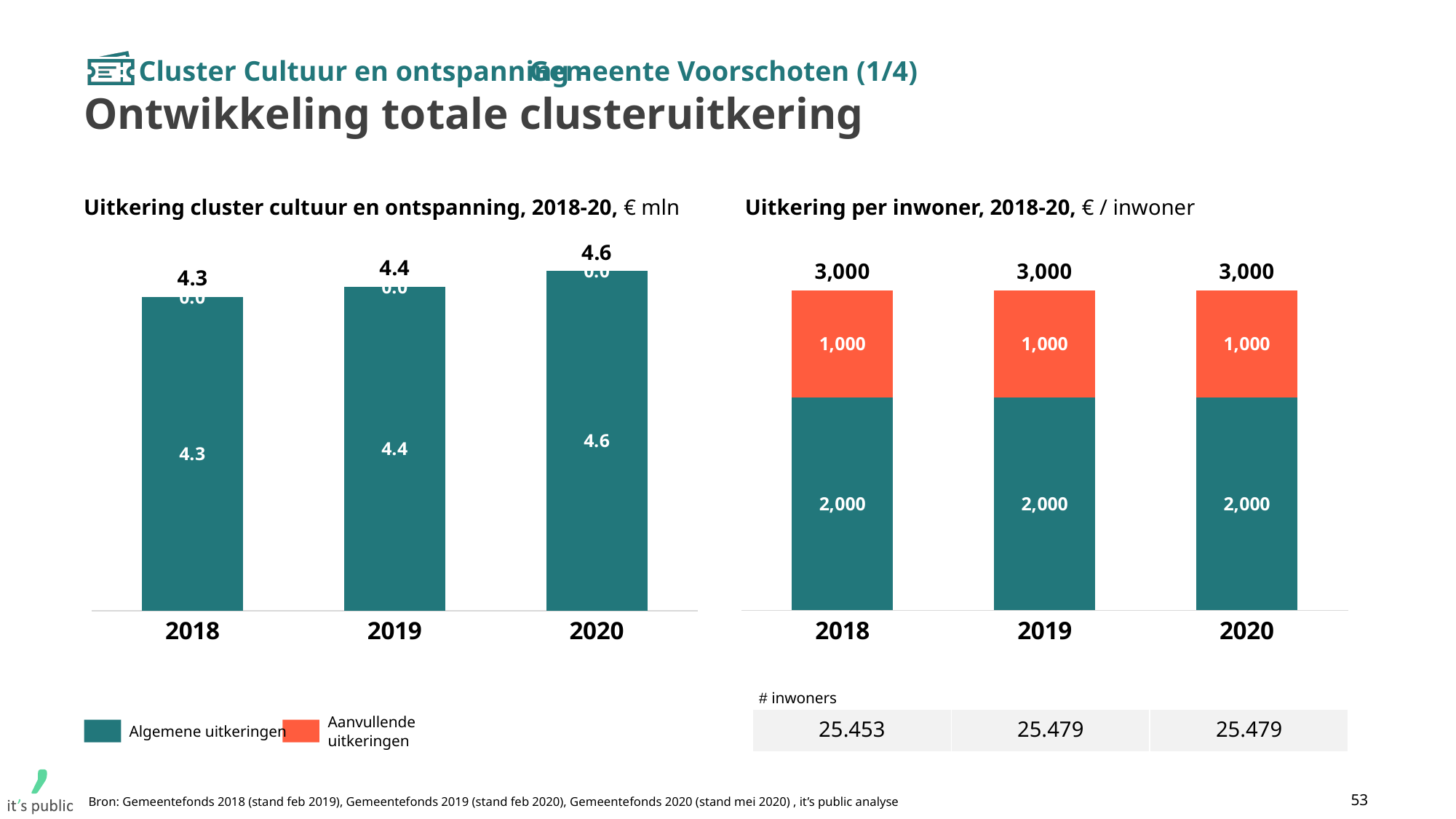
How many series does the legend list for the charts on this slide? 2 In the left chart (Uitkering cluster cultuur en ontspanning), which year has the highest total? 2020 How many years are shown on the x axis of the right chart (Uitkering per inwoner)? 3 In the left chart (Uitkering cluster cultuur en ontspanning), do the totals rise or fall from 2018 to 2020? rise In the right chart (Uitkering per inwoner), what is the total of the stacked bar for 2020? 3,000 In the left chart (Uitkering cluster cultuur en ontspanning), what is the total value for 2018? 4.3 In the left chart (Uitkering cluster cultuur en ontspanning), what is the value of Algemene uitkeringen for 2020? 4.6 In the right chart (Uitkering per inwoner), which is larger for 2019: Algemene uitkeringen or Aanvullende uitkeringen? Algemene uitkeringen In the left chart (Uitkering cluster cultuur en ontspanning), what is the value of Aanvullende uitkeringen for 2019? 0.0 In the right chart (Uitkering per inwoner), what is the value of Aanvullende uitkeringen for 2018? 1,000 In the left chart (Uitkering cluster cultuur en ontspanning), which year has the lowest total? 2018 In the left chart (Uitkering cluster cultuur en ontspanning), what is the difference between the 2020 total and the 2018 total? 0.3